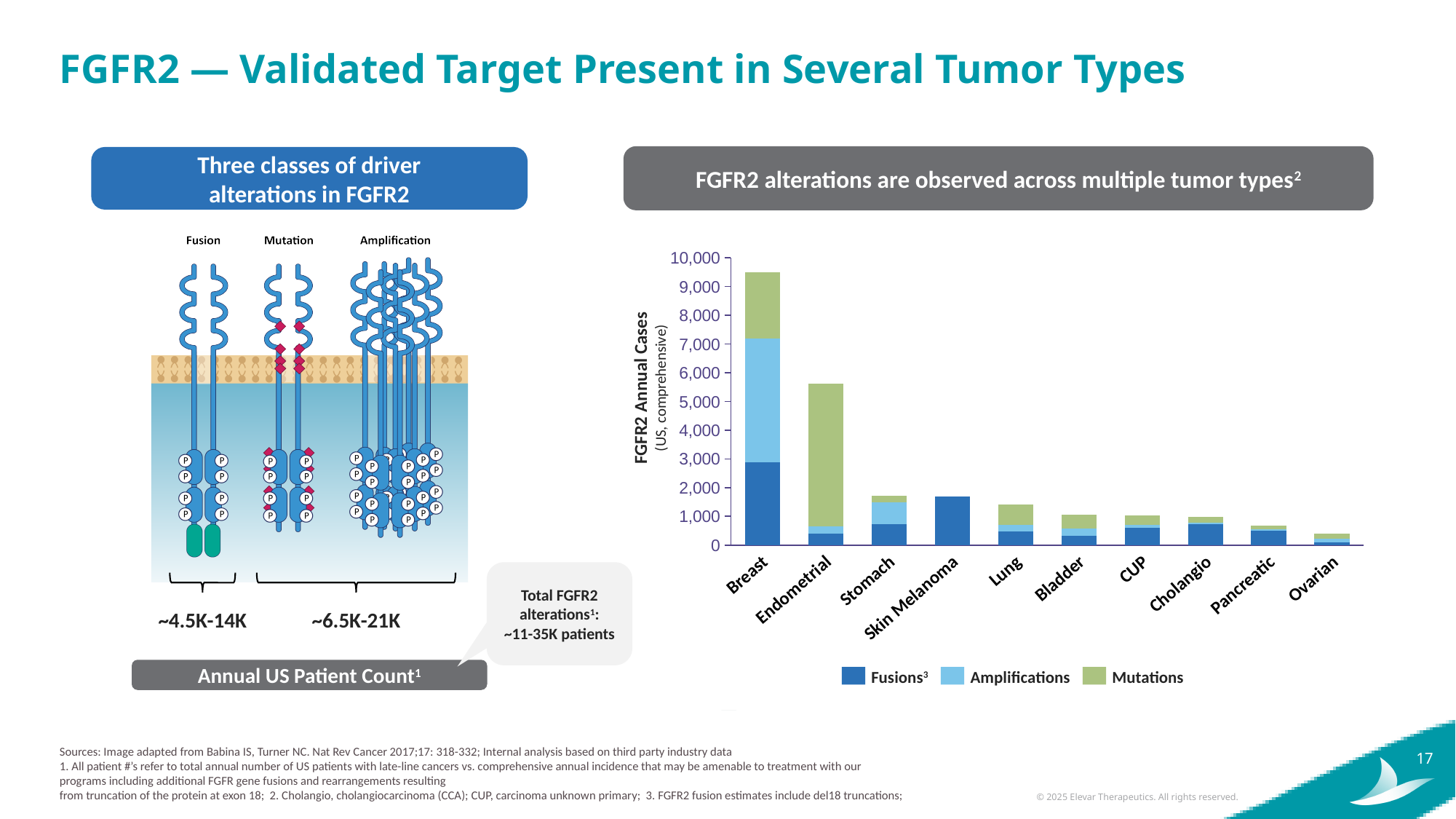
What kind of chart is shown on the right side of the slide? Stacked bar chart Is the total value for Endometrial greater or less than 5,000? greater Which has a larger total of FGFR2 annual cases, Breast or Endometrial? Breast Is the total value for Skin Melanoma greater or less than 2,000? less How many tumor types are shown on the x axis of the chart? 10 Is the total value for Ovarian greater or less than 1,000? less Which tumor type has the highest total FGFR2 annual cases in the chart? Breast Do the total bar heights generally rise or fall moving from left to right along the x axis? Fall Which tumor type has the lowest total FGFR2 annual cases in the chart? Ovarian What is the label of the y axis of the chart? FGFR2 Annual Cases (US, comprehensive) How many series does the chart's legend list? 3